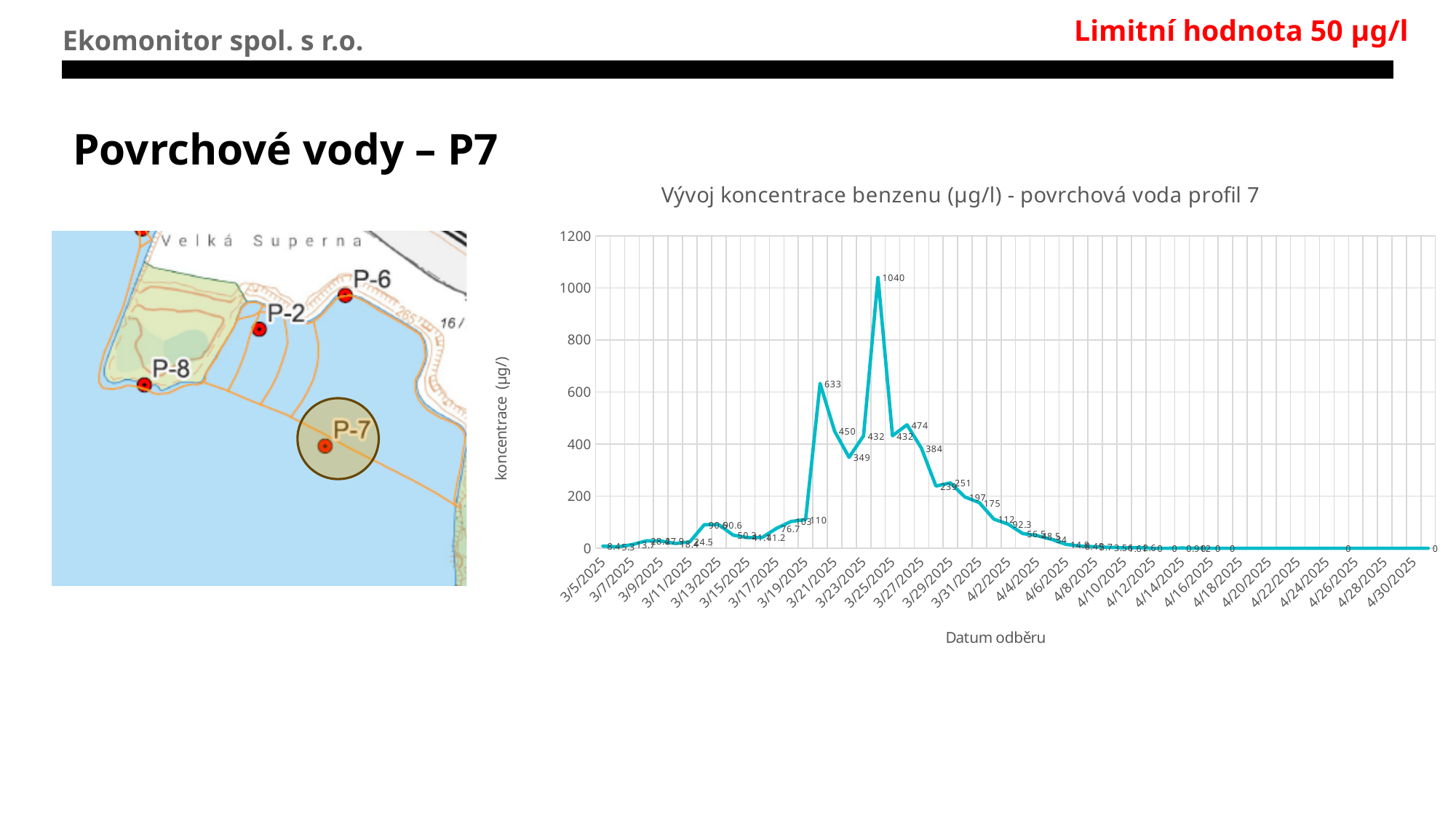
What is the title of the chart? Vývoj koncentrace benzenu (µg/l) - povrchová voda profil 7 How many data series (lines) are plotted on the chart? 1 Do the values rise or fall along the x axis after the 1040 peak? fall What is the value of the first plotted point, at 3/5/2025? 8.4 Is the highest peak on the chart greater or less than 1000? greater What is the value of the last plotted point, at 4/30/2025? 0 What is the highest benzene concentration value labelled on the chart? 1040 What is the label of the y axis? koncentrace (µg/l) What is the highest tick value shown on the y axis? 1200 What is the value of the second-highest peak labelled on the chart, just before the 1040 peak? 633 What type of chart is shown on the slide? line chart What is the difference between the highest peak (1040) and the earlier peak of 633? 407